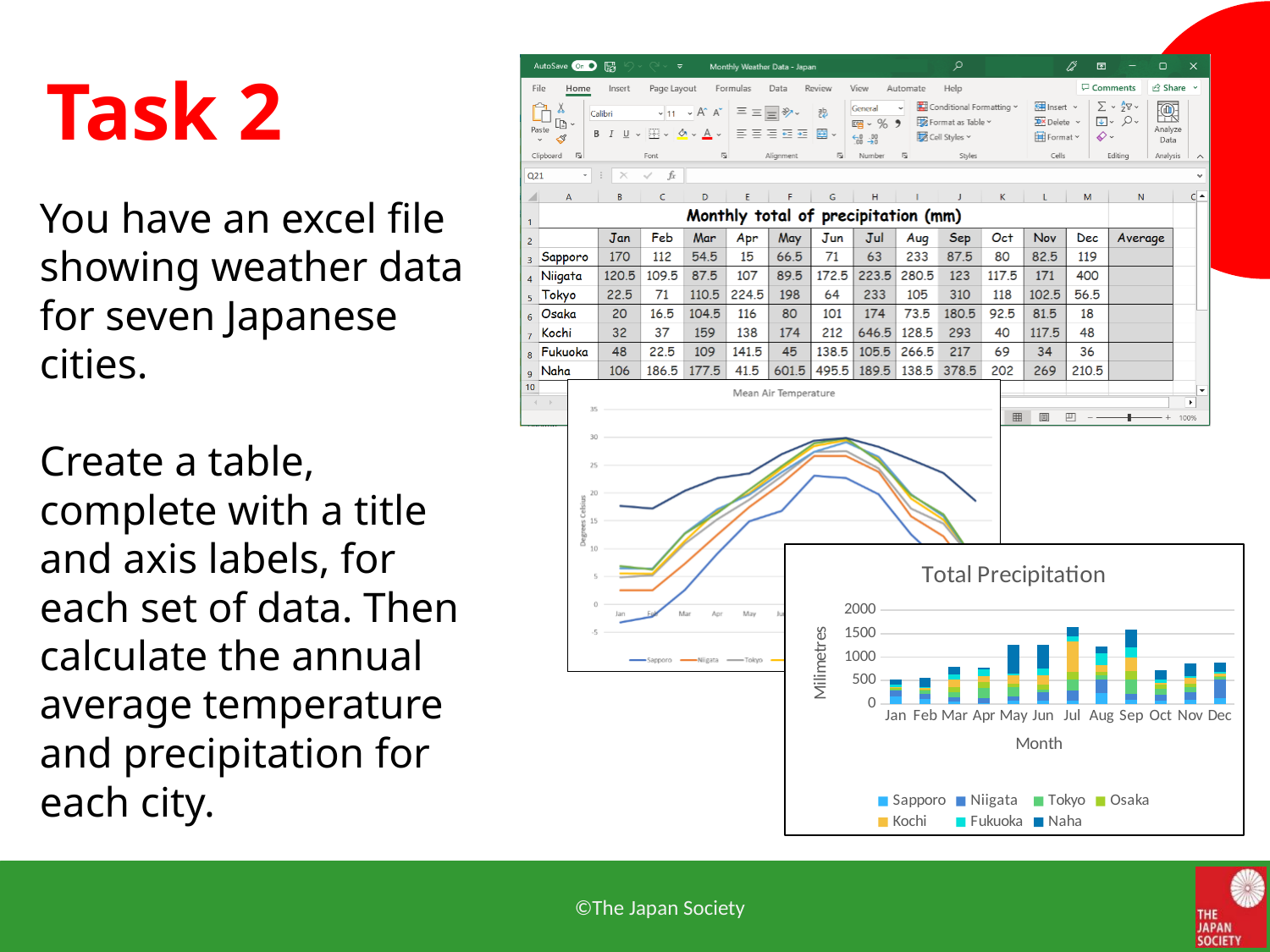
What type of chart is the 'Mean Air Temperature' chart? line chart In the 'Total Precipitation' chart, is the total for Jan greater or less than 1000? less In the 'Total Precipitation' chart, how many series does the legend list? 7 In the 'Total Precipitation' chart, is the total for May greater or less than 1000? greater What is the y-axis label of the 'Total Precipitation' chart? Milimetres In the 'Total Precipitation' chart, which stacked bar is taller, Jan or Jul? Jul In the 'Total Precipitation' chart, how many months are shown on the x axis? 12 In the 'Total Precipitation' chart, is the total for Jul greater or less than 1500? greater What is the y-axis label of the 'Mean Air Temperature' chart? Degrees Celsius What type of chart is the 'Total Precipitation' chart? stacked bar chart In the 'Total Precipitation' chart, which month has the tallest stacked bar? Jul In the 'Total Precipitation' chart, which stacked bar is taller, Mar or May? May